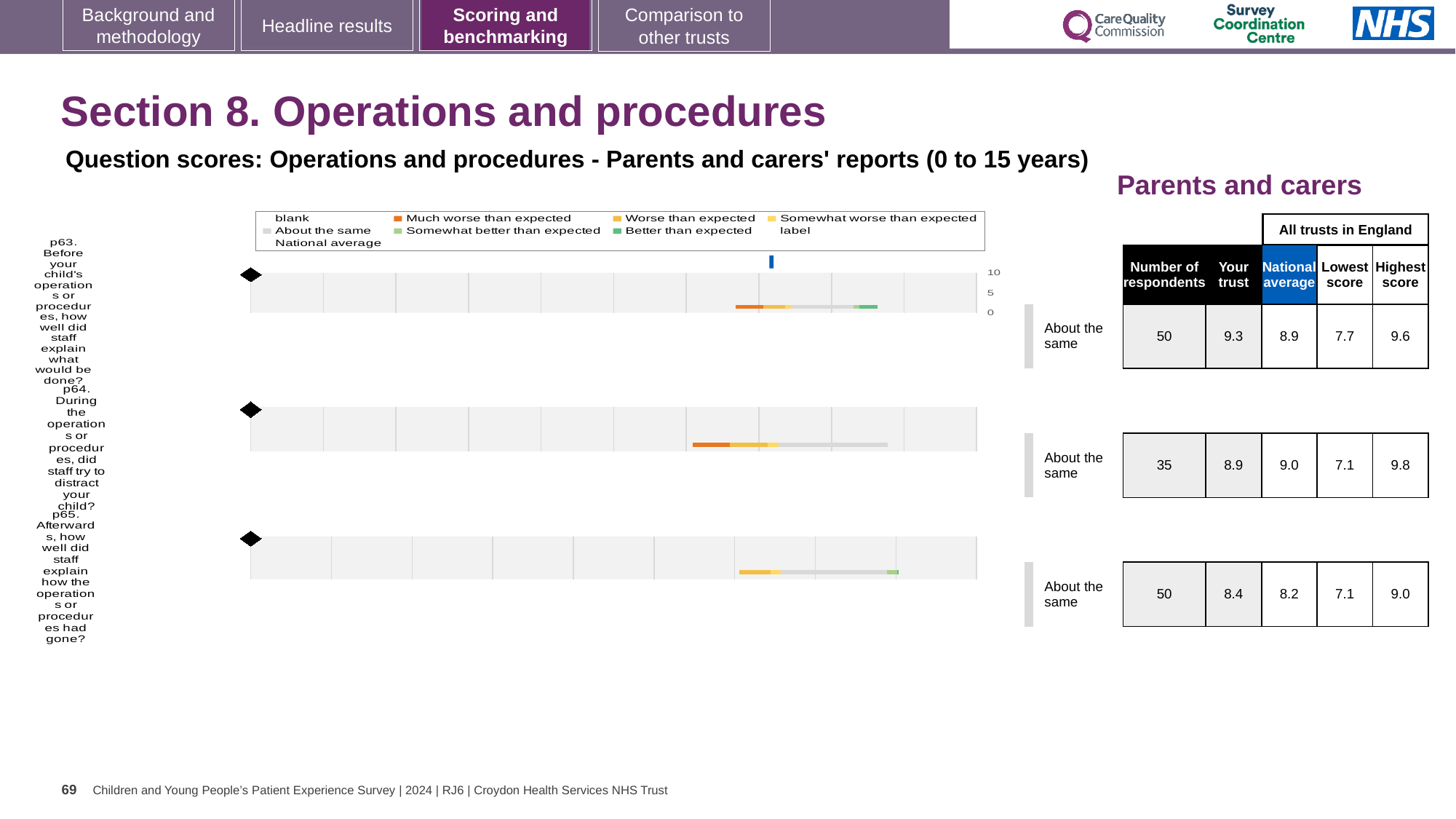
How many respondents answered question p64? 35 What benchmark category is shown for each of the three questions? About the same How many questions are plotted on this slide? 3 Which of the three questions has the lowest 'Your trust' score? p65 What is the national average score for question p64 (During the operations or procedures, did staff try to distract your child?)? 9.0 Which of the three questions has the highest 'Your trust' score? p63 What is the highest score among all trusts in England for question p65 (Afterwards, how well did staff explain how the operations or procedures had gone?)? 9.0 What is the lowest score among all trusts in England for question p63? 7.7 What is the difference between the 'Your trust' score and the national average for question p63? 0.4 What is the 'Your trust' score for question p63 (Before your child's operations or procedures, how well did staff explain what would be done?)? 9.3 Which legend entry is shown in dark green? Better than expected For question p64, is the 'Your trust' score higher or lower than the national average? lower